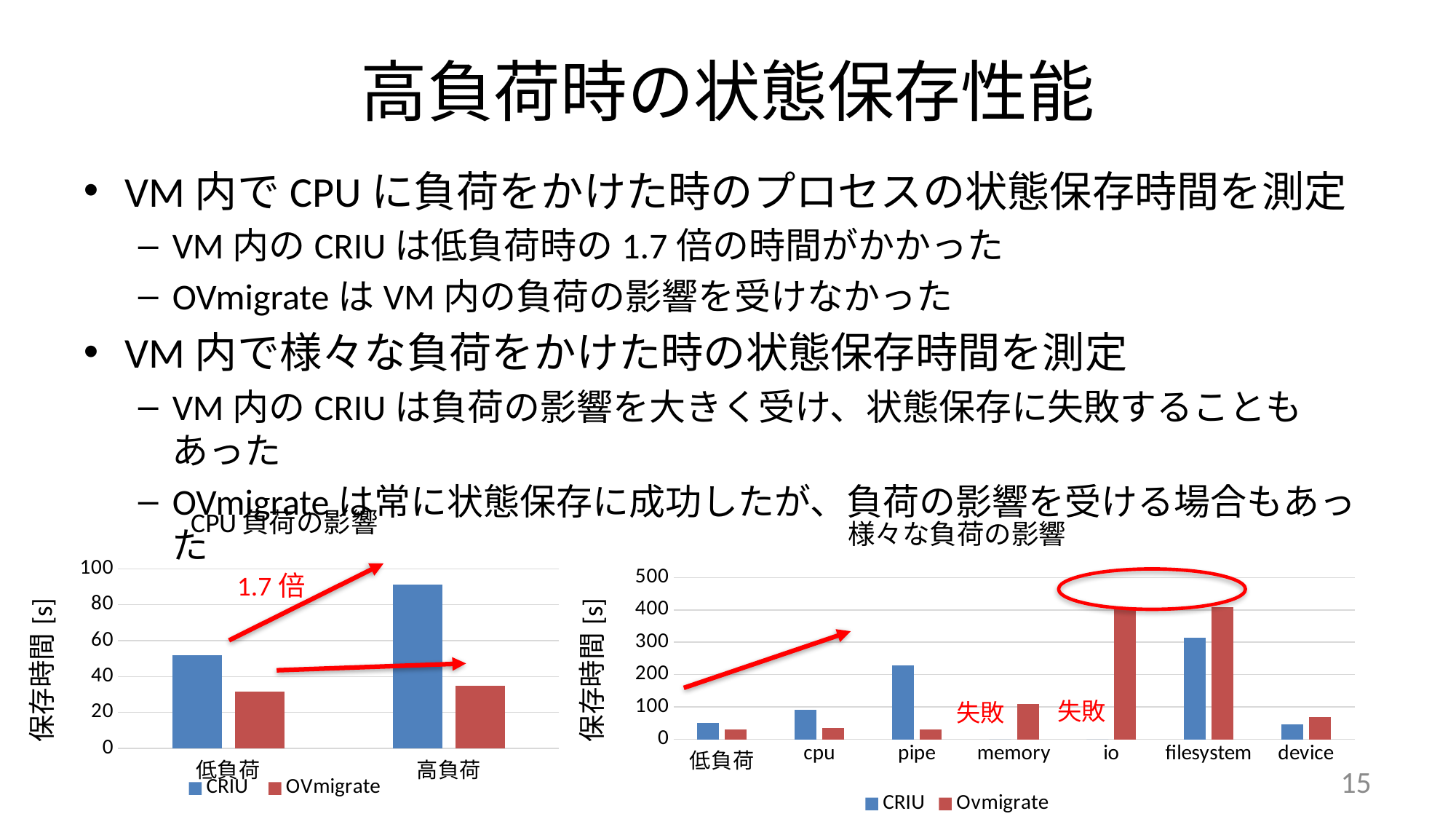
In the left chart 'CPU 負荷の影響', is the OVmigrate value for 低負荷 greater or less than 40? less What kind of chart is the left chart titled 'CPU 負荷の影響'? bar chart In the left chart 'CPU 負荷の影響', does the CRIU value rise or fall from 低負荷 to 高負荷? rise In the right chart '様々な負荷の影響', is the CRIU value for pipe greater or less than 200? greater What is the y-axis label of the right chart '様々な負荷の影響'? 保存時間 [s] In the right chart '様々な負荷の影響', how many categories are shown on the x axis? 7 In the left chart 'CPU 負荷の影響', which is larger for 高負荷, CRIU or OVmigrate? CRIU In the right chart '様々な負荷の影響', is the Ovmigrate value for io greater or less than 300? greater In the right chart '様々な負荷の影響', which category has the highest CRIU bar? filesystem In the right chart '様々な負荷の影響', which is larger for filesystem, CRIU or Ovmigrate? Ovmigrate In the left chart 'CPU 負荷の影響', how many series does the legend list? 2